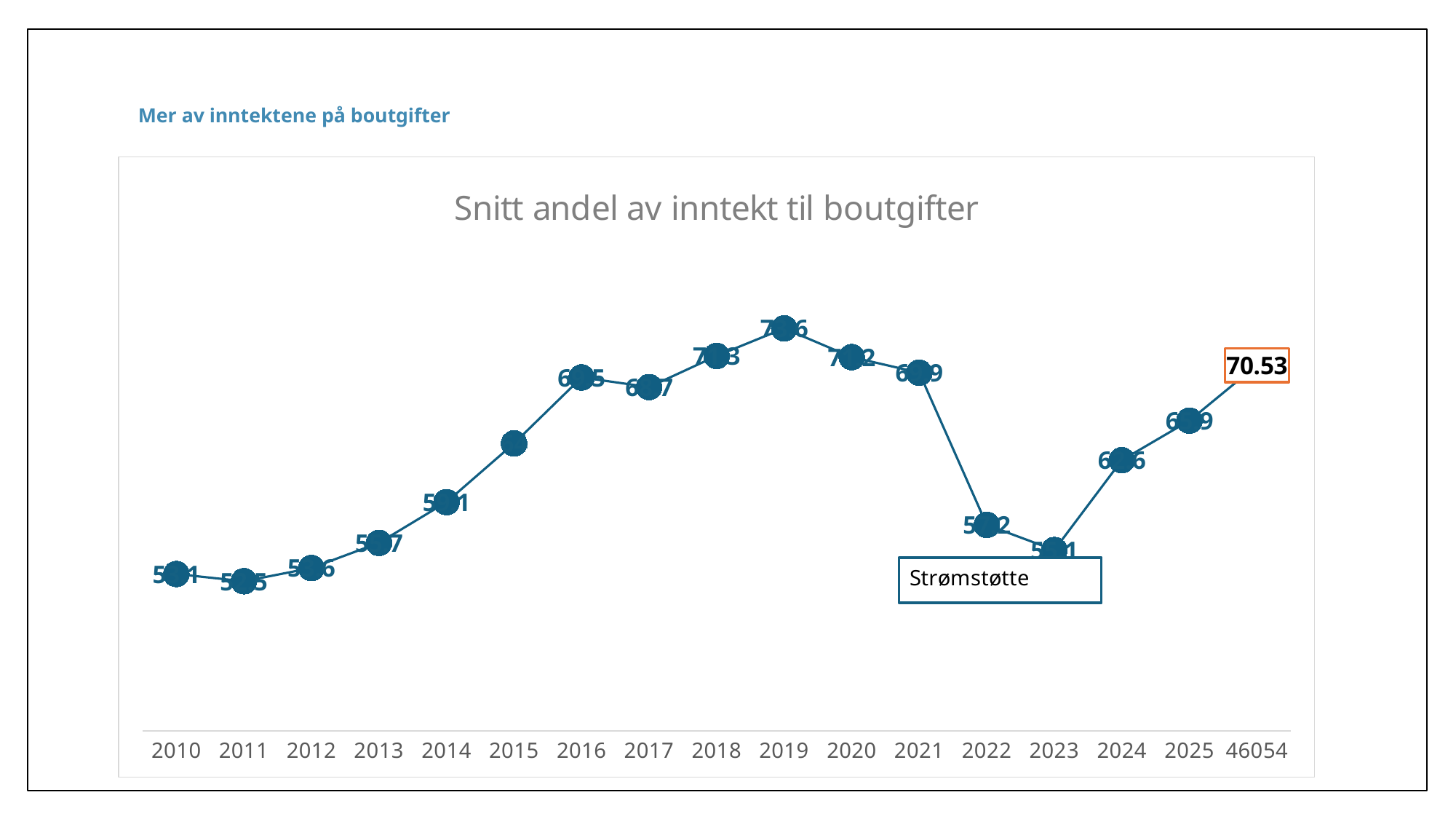
Which is larger, the value for 2019 or the value for 2023? 2019 Do the values rise or fall from 2021 to 2023? fall Do the values rise or fall from 2023 to the last point (46054)? rise What is the value of the last data point, labelled 46054 on the x axis? 70.53 What kind of chart is shown on the slide? line chart Which is larger, the value for 2021 or the value for 2022? 2021 How many data points are plotted on the line? 17 What text is shown in the annotation box near the 2022–2023 points? Strømstøtte Which year has the highest value on the chart? 2019 Do the values generally rise or fall from 2011 to 2019? rise What is the title of the chart? Snitt andel av inntekt til boutgifter Which is larger, the value for 2014 or the value for 2016? 2016